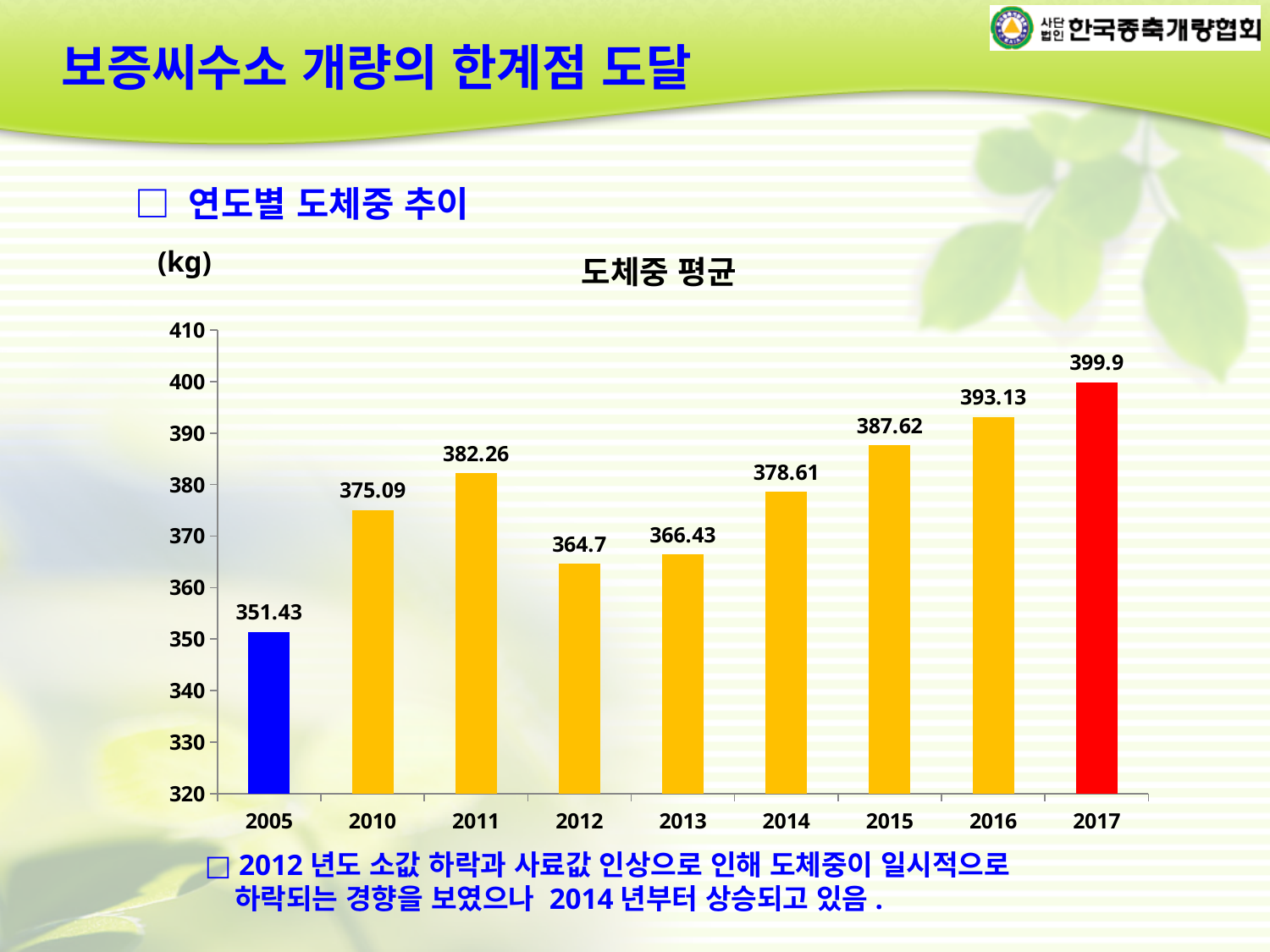
What is the difference between the values for 2011 and 2012 in the 도체중 평균 chart? 17.56 What colour is the bar for 2017 in the 도체중 평균 chart? red Which is larger in the 도체중 평균 chart, the value for 2011 or the value for 2014? 2011 What is the value for 2016 in the 도체중 평균 chart? 393.13 What is the difference between the values for 2017 and 2005 in the 도체중 평균 chart? 48.47 Which year has the lowest value in the 도체중 평균 chart? 2005 Do the values in the 도체중 평균 chart rise or fall from 2014 to 2017? rise What is the value for 2005 in the 도체중 평균 chart? 351.43 Which year has the highest value in the 도체중 평균 chart? 2017 How many years are shown on the x axis of the 도체중 평균 chart? 9 What is the value for 2012 in the 도체중 평균 chart? 364.7 What kind of chart is the 도체중 평균 chart? bar chart